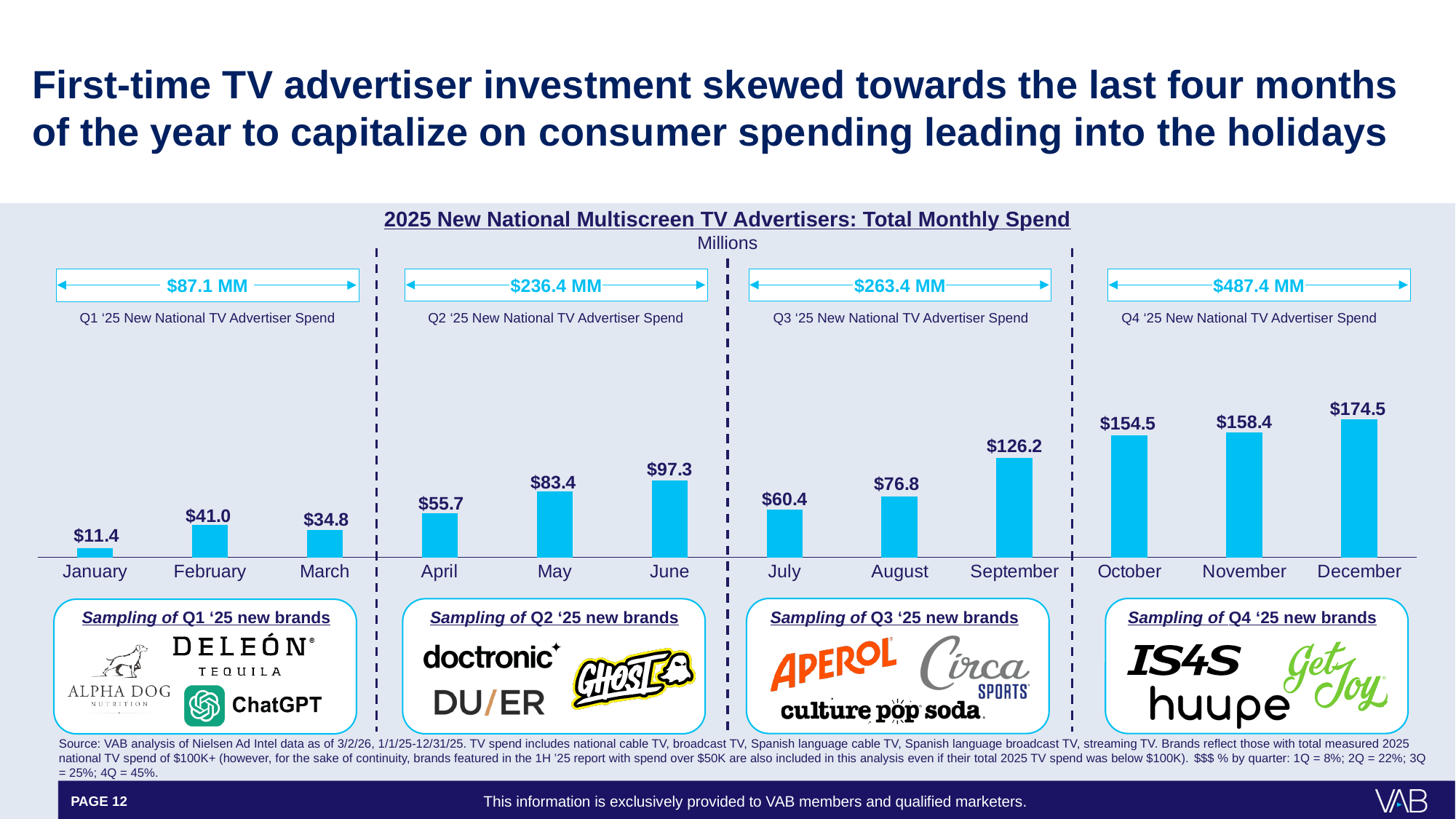
How many months are plotted on the chart? 12 Which month has the lowest value? January Which month has the highest value? December Do the values rise or fall from October to December? Rise Which is larger, the value for February or the value for March? February What is the difference between the values for December and November? $16.1 What is the value for September? $126.2 What is the title of the chart? 2025 New National Multiscreen TV Advertisers: Total Monthly Spend What is the difference between the values for June and April? $41.6 What kind of chart is shown on the slide? Bar chart What is the value for January? $11.4 What is the total Q4 '25 New National TV Advertiser Spend shown on the slide? $487.4 MM